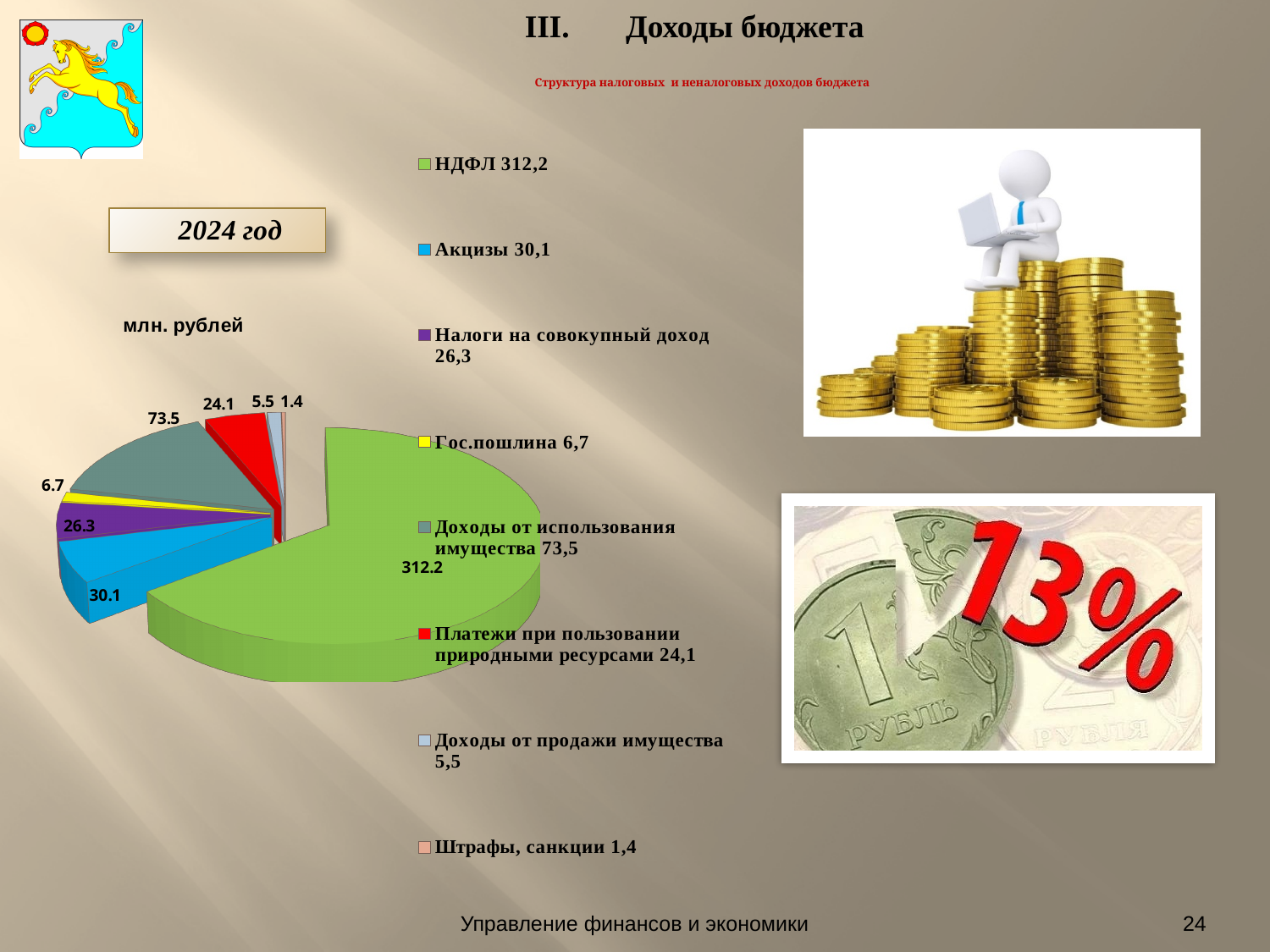
What is the value for НДФЛ in the pie chart? 312.2 What is the value for Доходы от использования имущества? 73.5 Which category has the largest slice of the pie? НДФЛ Which category has the smallest slice of the pie? Штрафы, санкции What kind of chart is shown on the slide? Pie chart What is the value for Акцизы? 30.1 Which is larger, Акцизы or Налоги на совокупный доход? Акцизы What is the value for Штрафы, санкции? 1.4 What is the difference between НДФЛ and Доходы от использования имущества? 238.7 How many categories does the pie chart have? 8 What is the difference between Доходы от использования имущества and Акцизы? 43.4 What unit is stated for the values in the pie chart? млн. рублей